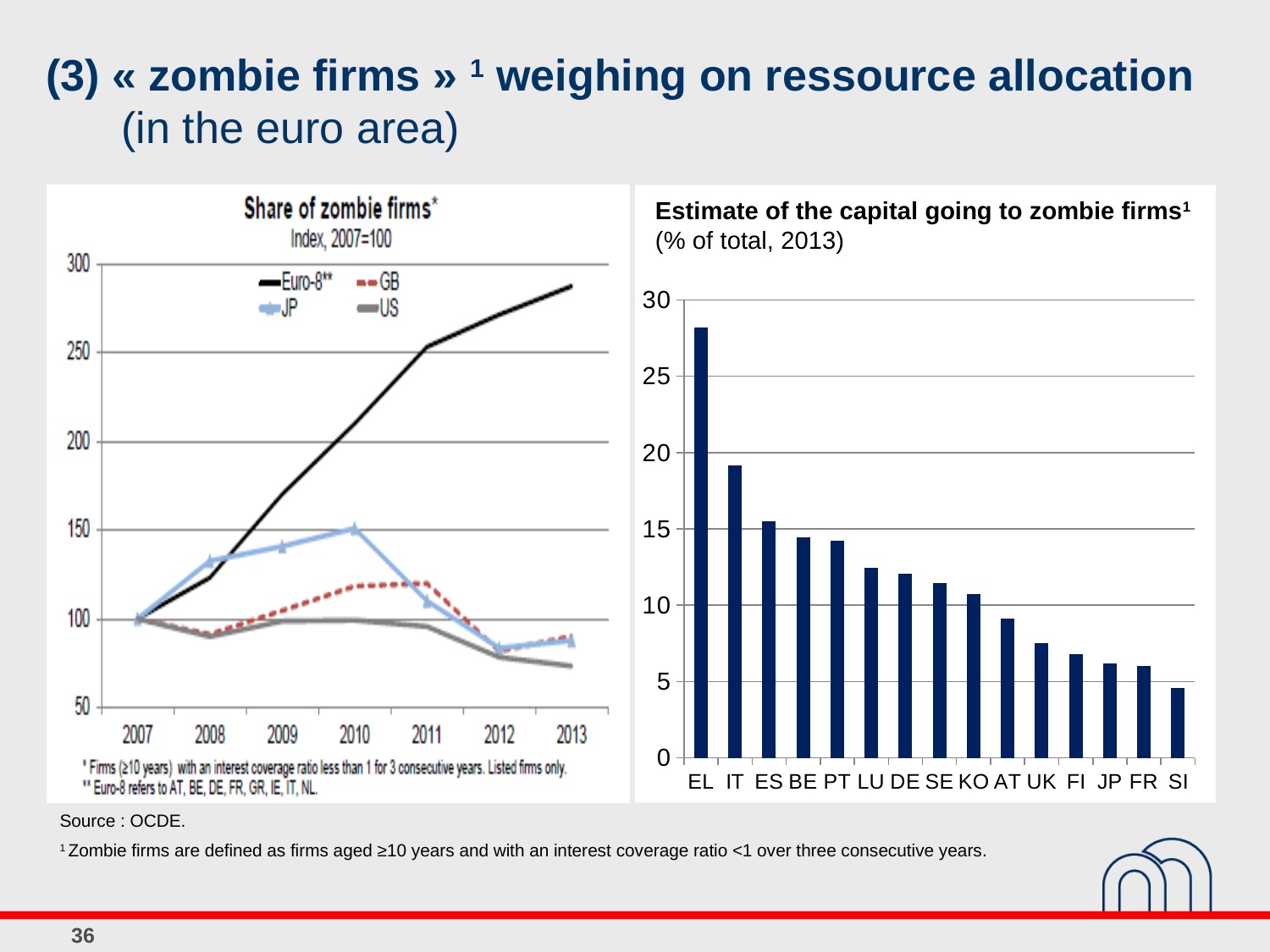
In the left chart 'Share of zombie firms', what is the index value of the Euro-8 series in 2007? 100 In the right chart 'Estimate of the capital going to zombie firms', is the value for SI greater or less than 5? less In the right chart 'Estimate of the capital going to zombie firms', which country has the lowest value? SI In the right chart 'Estimate of the capital going to zombie firms', is the value for EL greater or less than 25? greater In the right chart 'Estimate of the capital going to zombie firms', which is larger, the value for IT or the value for ES? IT In the left chart 'Share of zombie firms', does the Euro-8 series rise or fall from 2007 to 2013? rise What type of chart is the right chart titled 'Estimate of the capital going to zombie firms'? bar chart In the right chart 'Estimate of the capital going to zombie firms', which country has the highest value? EL In the right chart 'Estimate of the capital going to zombie firms', how many countries are shown? 15 In the left chart 'Share of zombie firms', is the value for Euro-8 in 2013 greater or less than 250? greater What type of chart is the left chart titled 'Share of zombie firms'? line chart In the left chart 'Share of zombie firms', how many series does the legend list? 4